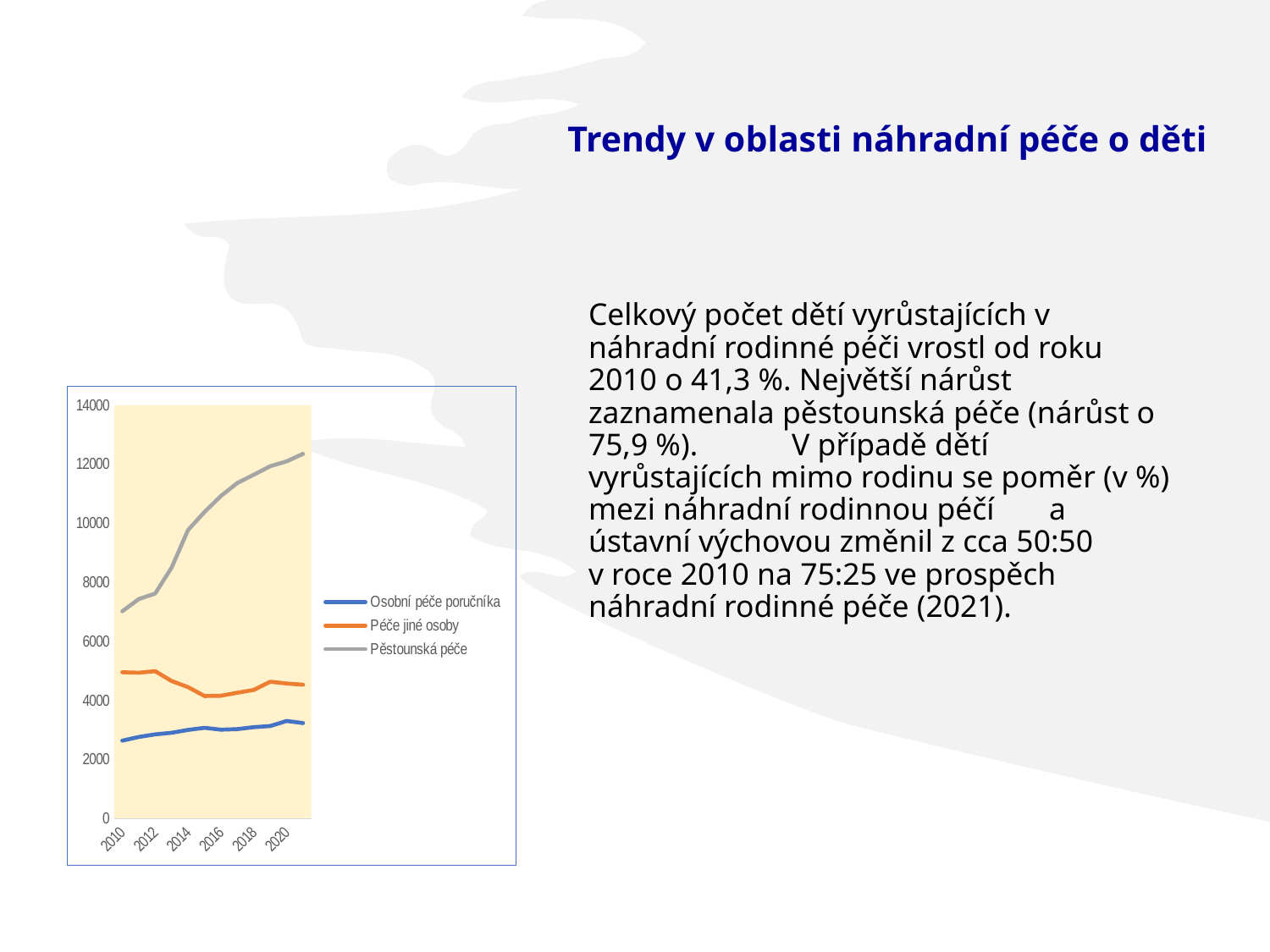
Is the value for Osobní péče poručníka in 2010 greater or less than 2000? greater Is the value for Pěstounská péče in 2010 greater or less than 6000? greater What colour is the Pěstounská péče line in the legend? grey What is the maximum value shown on the vertical axis? 14000 Does the Pěstounská péče line rise or fall from 2010 to 2020? rises Is the value for Pěstounská péče in 2018 greater or less than 10000? greater In 2010, which is larger: Pěstounská péče or Péče jiné osoby? Pěstounská péče How many series does the chart legend list? 3 Which series has the highest values throughout the chart? Pěstounská péče Which series has the lowest values throughout the chart? Osobní péče poručníka What kind of chart is shown on the slide? line chart